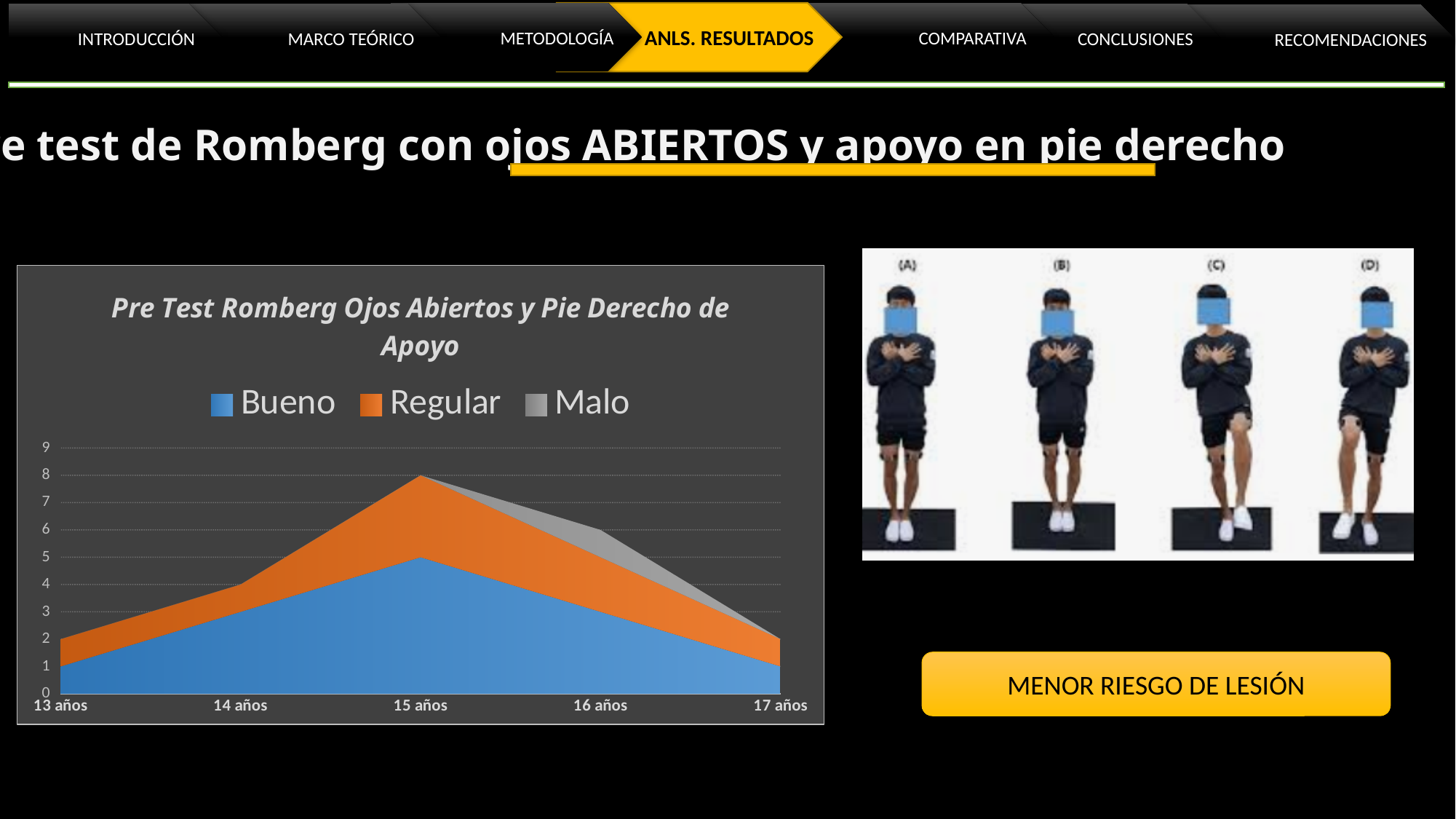
Is the stacked total at 15 años greater or less than 6? greater Is the value for Bueno at 15 años greater or less than 4? greater How many age categories are shown on the x axis of the chart? 5 Which is larger, the Bueno value at 14 años or at 17 años? 14 años Do the Bueno values rise or fall from 15 años to 17 años? fall Which age category has the highest value for Bueno? 15 años What is the title of the chart? Pre Test Romberg Ojos Abiertos y Pie Derecho de Apoyo How many series does the chart's legend list? 3 Is the value for Bueno at 13 años greater or less than 2? less What colour represents the Regular series in the chart? orange Do the Bueno values rise or fall from 13 años to 15 años? rise What kind of chart is shown on the slide? area chart